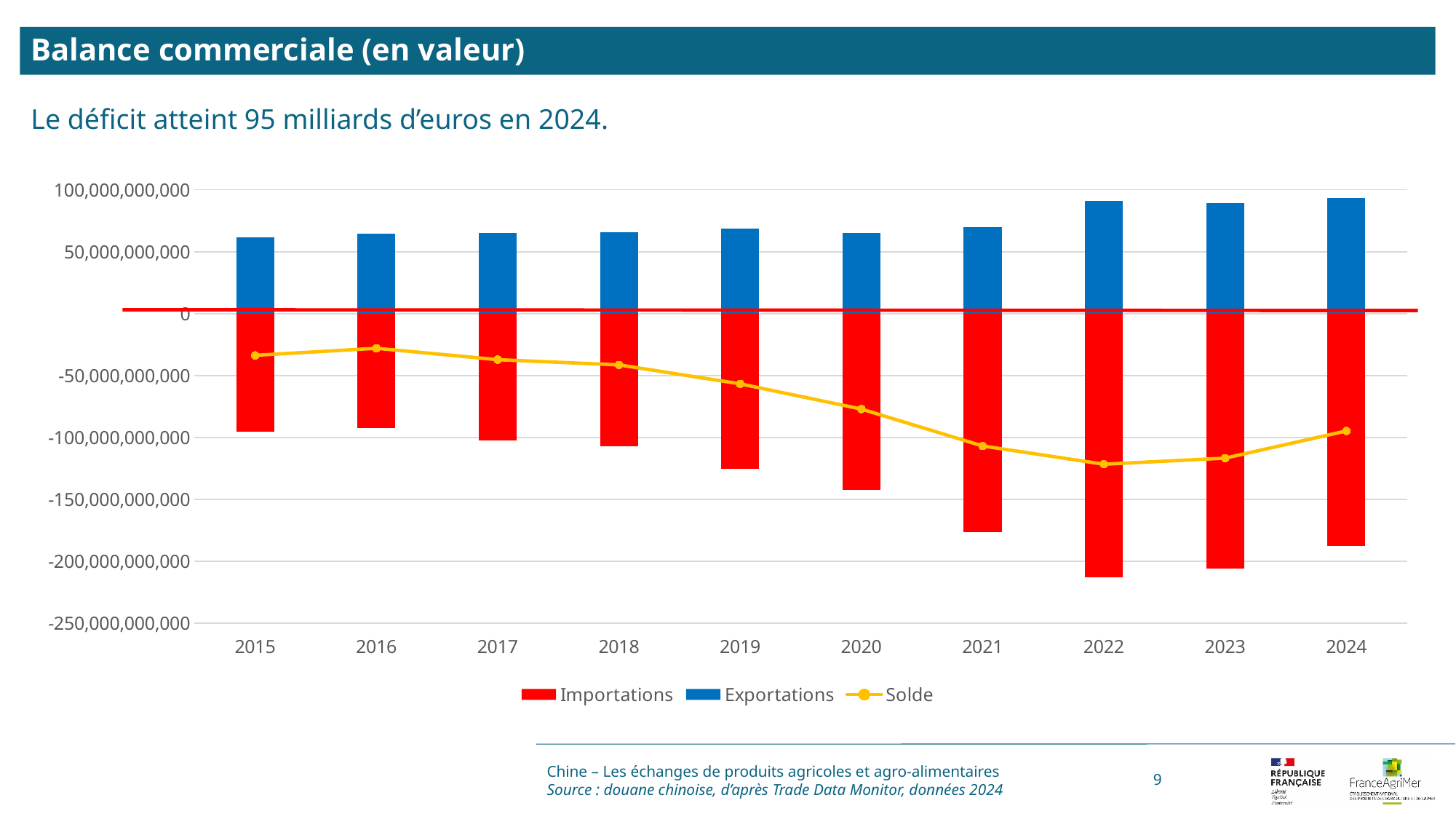
Is the Importations value for 2021 greater or less than -150,000,000,000? less What kind of chart is shown on the slide? bar chart with a line Which year has the highest Exportations value? 2024 How many series does the chart legend list? 3 Which year has the larger Exportations value, 2015 or 2019? 2019 In which year is the Importations bar the longest (most negative)? 2022 Which year has the lowest Exportations value? 2015 How many years are shown on the x axis of the chart? 10 Is the Exportations value for 2022 greater or less than 50,000,000,000? greater Does the Solde line rise or fall from 2016 to 2022? fall Is the Solde value for 2024 greater or less than -100,000,000,000? greater In which year does the Solde line reach its lowest point? 2022